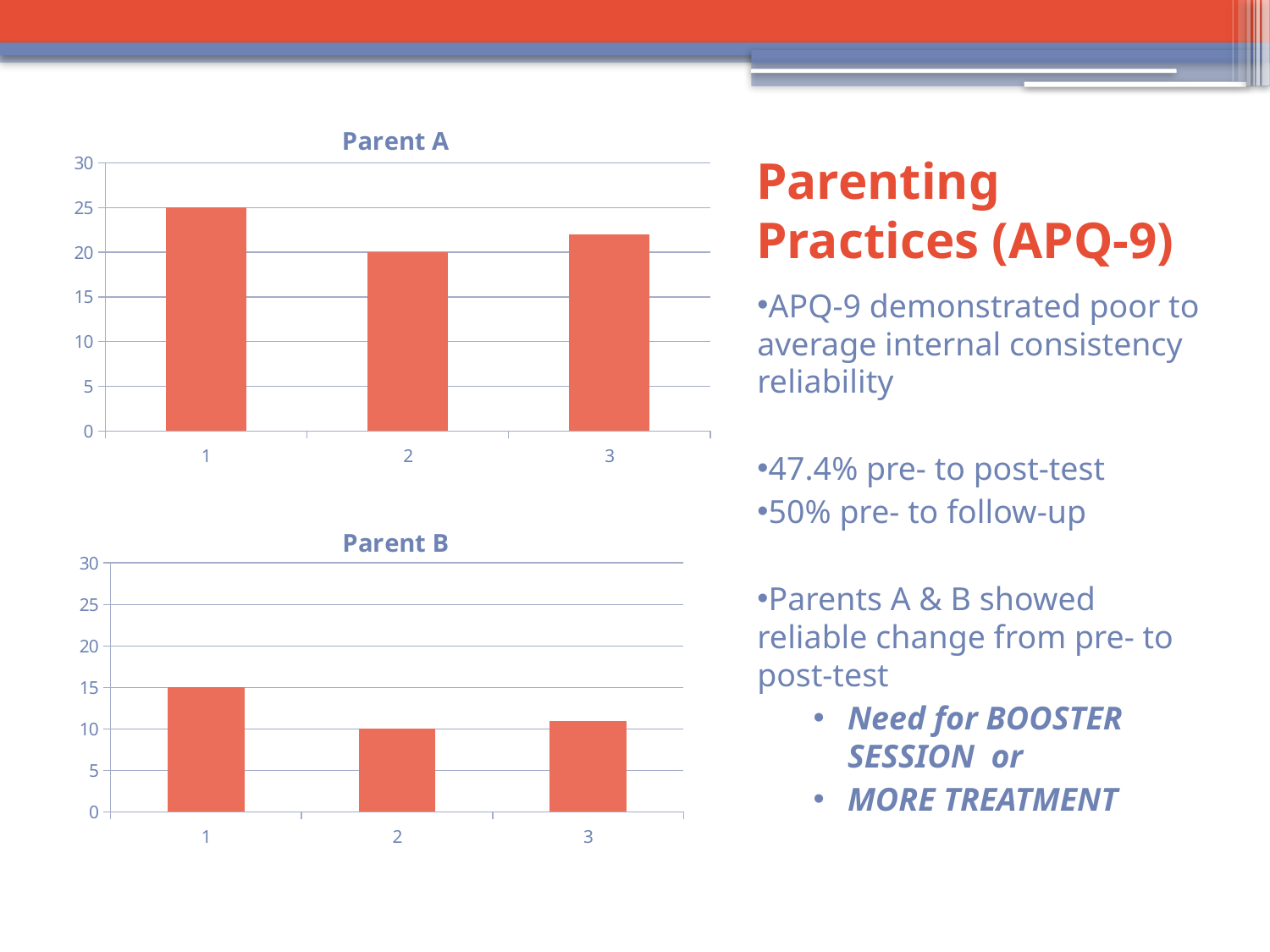
In the Parent B chart, what is the value for category 2? 10 In the Parent A chart, what is the difference between the values for category 1 and category 2? 5 In the Parent A chart, which category has the lowest value? 2 In the Parent B chart, what is the value for category 1? 15 In the Parent A chart, which category has the highest value? 1 In the Parent A chart, is the value for category 3 greater or less than 20? greater In the Parent B chart, is the value for category 3 greater or less than 15? less How many bars are shown in the Parent B chart? 3 In the Parent A chart, what is the value for category 2? 20 In the Parent B chart, which category has the highest value? 1 In the Parent A chart, what is the value for category 1? 25 What type of chart is the Parent A chart? bar chart